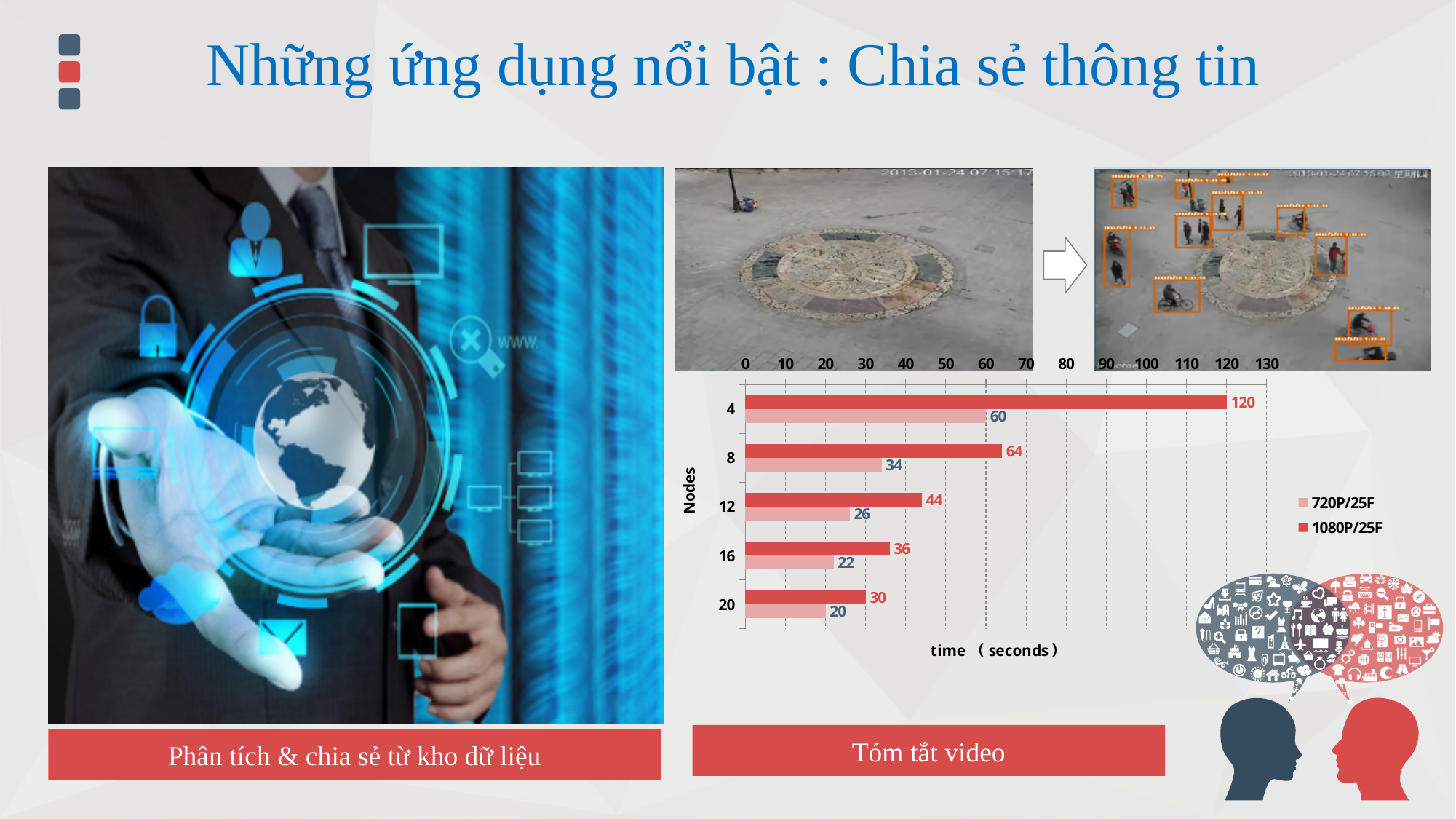
How many node categories are plotted on the chart? 5 What is the time in seconds for 1080P/25F at 4 nodes? 120 What kind of chart is shown on the slide? bar chart What is the difference between the 1080P/25F and 720P/25F times at 12 nodes? 18 Does the 1080P/25F time rise or fall as the number of nodes increases from 4 to 20? fall What is the time in seconds for 720P/25F at 20 nodes? 20 What is the time in seconds for 1080P/25F at 16 nodes? 36 How many series does the chart legend list? 2 Which node count has the lowest time for 720P/25F? 20 What is the time in seconds for 720P/25F at 8 nodes? 34 Which is larger at 8 nodes: the 1080P/25F time or the 720P/25F time? 1080P/25F Which node count has the highest time for 1080P/25F? 4